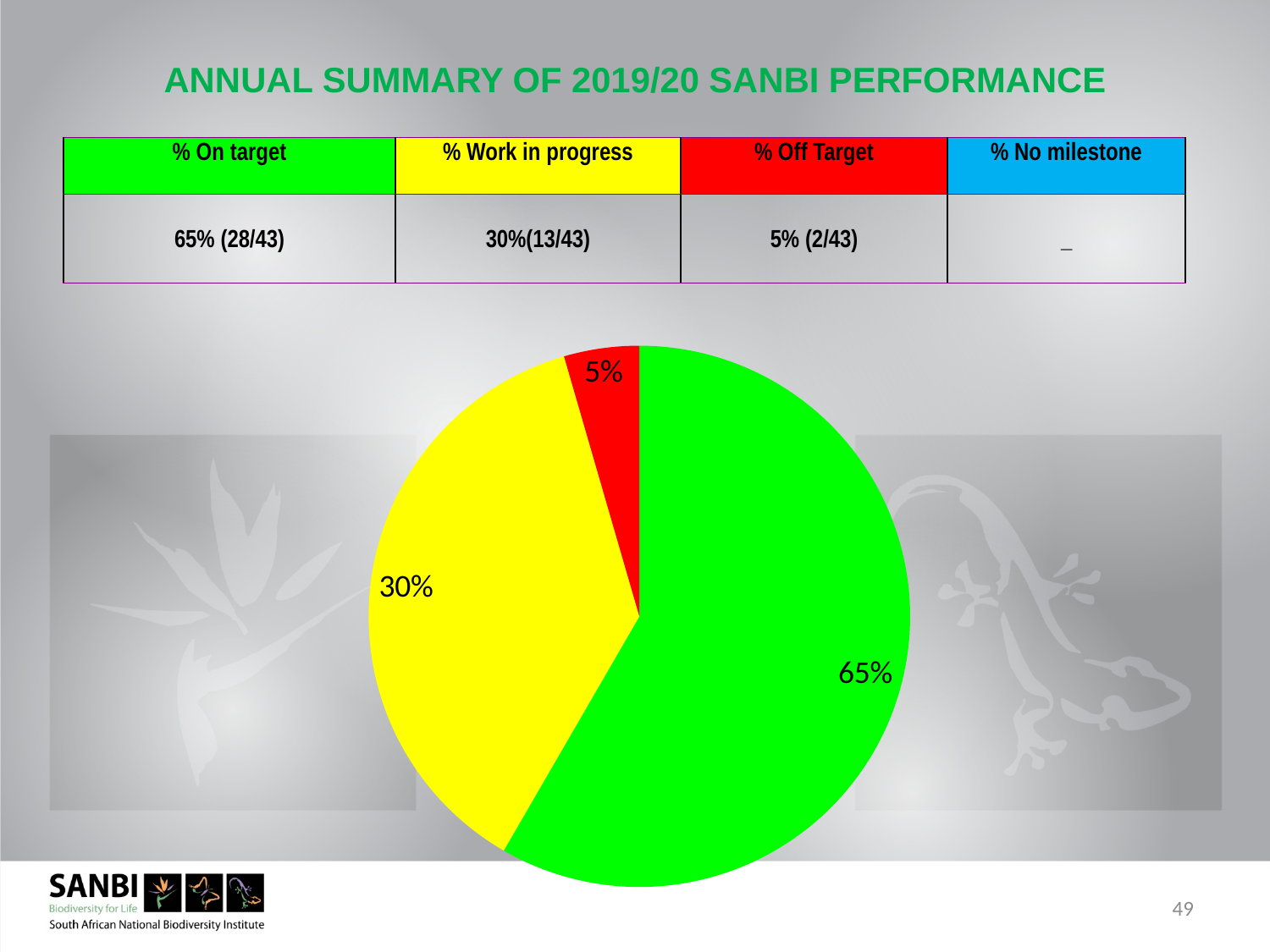
What percentage is shown on the green slice of the pie chart? 65% What percentage is shown on the yellow slice of the pie chart? 30% Which is larger in the pie chart, the yellow slice or the red slice? the yellow slice What is the title of the slide containing the pie chart? ANNUAL SUMMARY OF 2019/20 SANBI PERFORMANCE What is the difference between the green slice and the yellow slice of the pie chart? 35% What percentage is shown on the red slice of the pie chart? 5% According to the table above the pie chart, which category does the green colour represent? % On target What share of the pie does the red slice represent? 5% What kind of chart is shown on the slide? pie chart Which slice of the pie chart is the smallest? 5% (red, Off Target) How many slices does the pie chart have? 3 Which slice of the pie chart is the largest? 65% (green, On target)